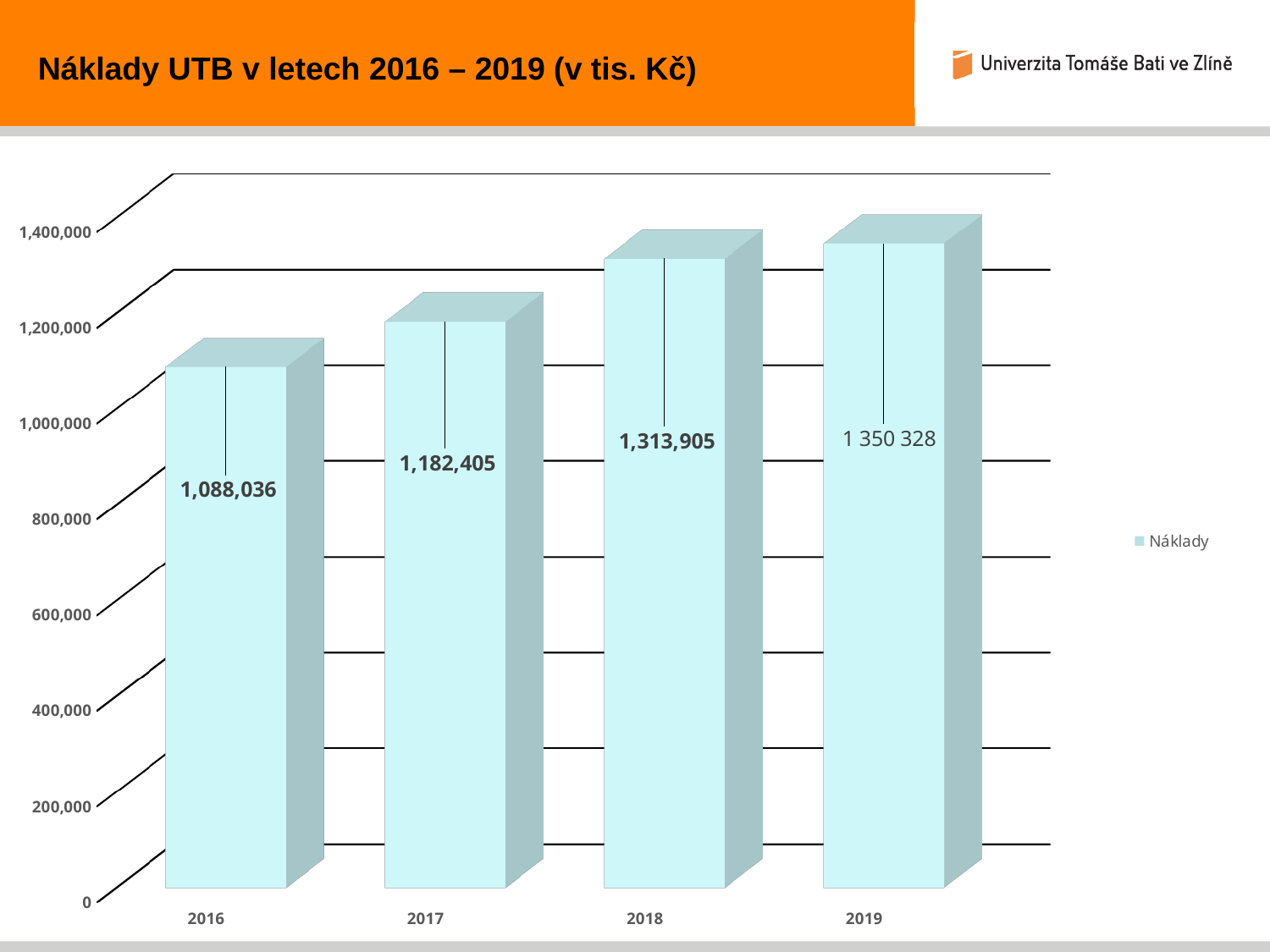
What is the value for 2019? 1 350 328 Do the values rise or fall from 2016 to 2019? rise What is the difference between the values for 2017 and 2016? 94,369 Is the value for 2016 greater or less than 1,000,000? greater What is the value for 2018? 1,313,905 How many years are shown on the x axis? 4 What is the value for 2016? 1,088,036 What is the difference between the values for 2018 and 2017? 131,500 Which year has the lowest value? 2016 Which is larger, the value for 2018 or the value for 2017? 2018 Which year has the highest value? 2019 What is the value for 2017? 1,182,405